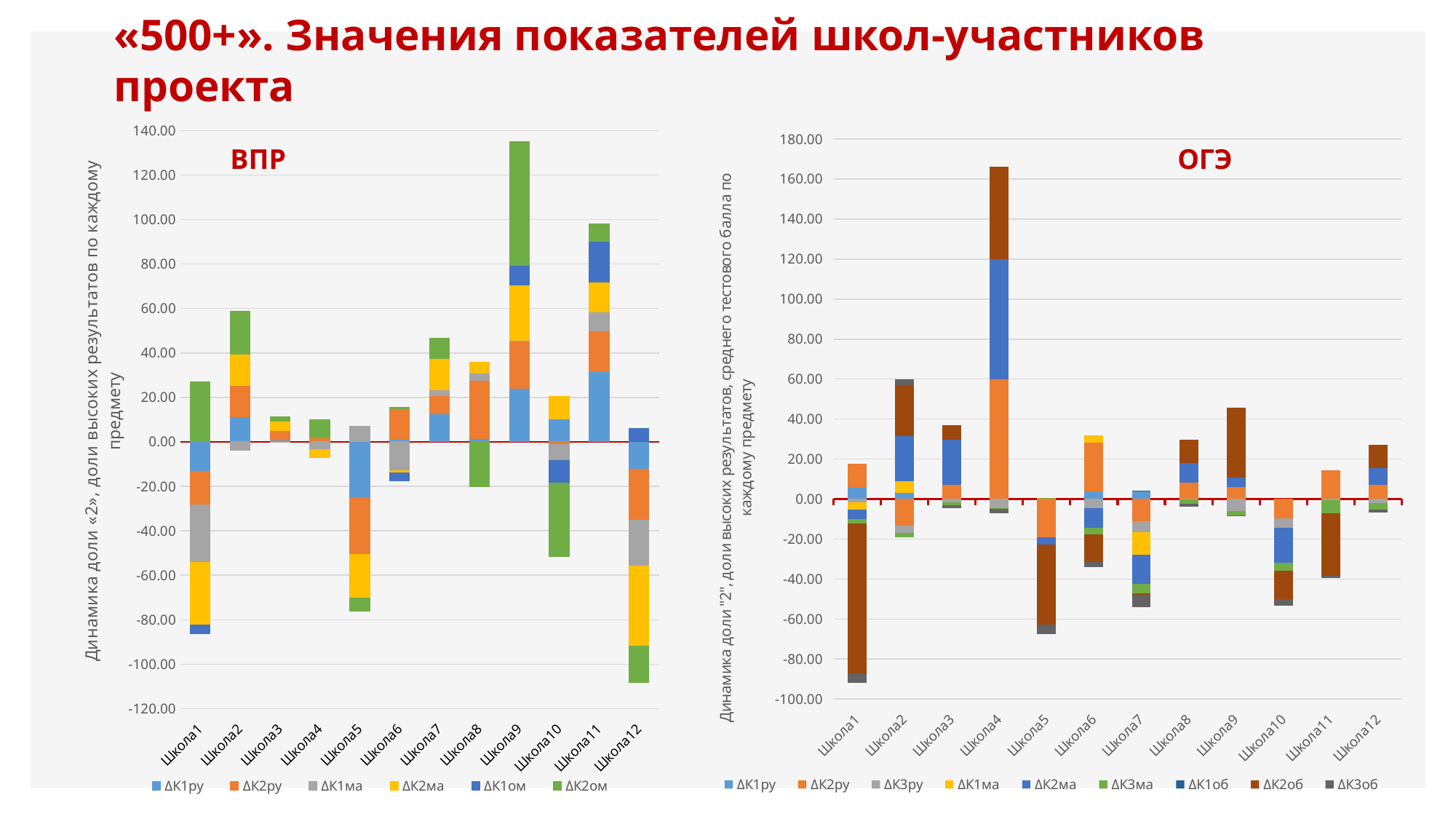
How many series does the legend of the ОГЭ chart list? 9 In the ОГЭ chart, is the top of the positive stack for Школа4 greater or less than 140? greater In the ОГЭ chart, is the bottom of the negative stack for Школа1 greater or less than -80? less How many series does the legend of the ВПР chart list? 6 In the ВПР chart, which school's bar extends furthest below zero? Школа12 In the ВПР chart, which school has the tallest positive stacked bar? Школа9 In the ОГЭ chart, which colour represents the series ΔК2об? brown In the ВПР chart, is the top of the positive stack for Школа9 greater or less than 120? greater How many schools (categories) are shown on the x axis of the ВПР chart? 12 What kind of chart is the ВПР chart on the left? stacked bar chart In the ОГЭ chart, which school's bar extends furthest below zero? Школа1 In the ОГЭ chart, which school has the tallest positive stacked bar? Школа4